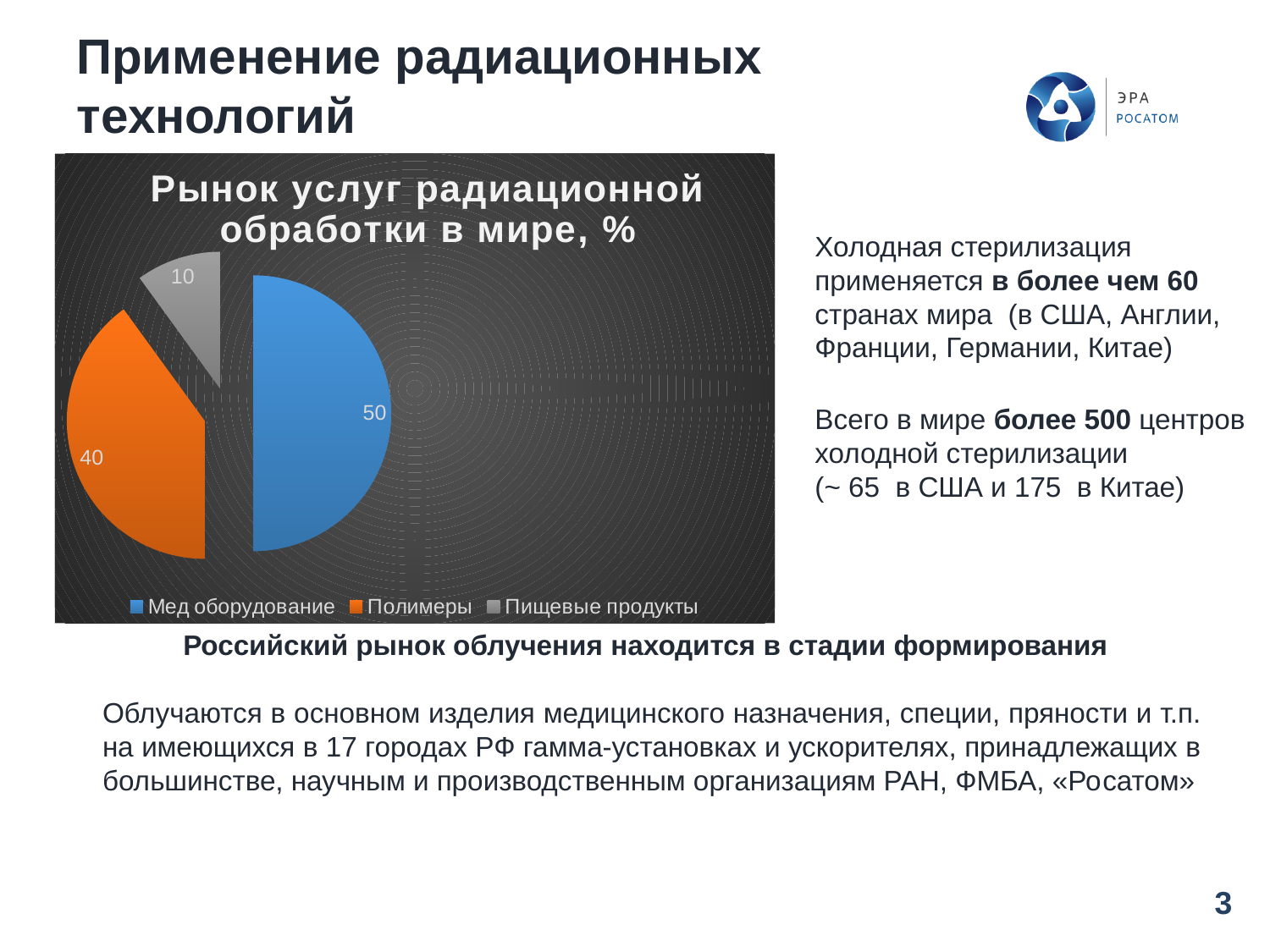
Which category has the smallest share of the pie chart? Пищевые продукты What type of chart is shown on the slide? Pie chart What is the difference between the values for Полимеры and Пищевые продукты? 30 What is the title of the pie chart? Рынок услуг радиационной обработки в мире, % Which category has the largest share of the pie chart? Мед оборудование What is the value for Мед оборудование in the pie chart? 50 What colour is the slice for Полимеры? Orange Which is larger, the value for Полимеры or the value for Пищевые продукты? Полимеры What is the difference between the values for Мед оборудование and Полимеры? 10 How many categories does the pie chart show? 3 What is the value for Пищевые продукты in the pie chart? 10 What is the value for Полимеры in the pie chart? 40